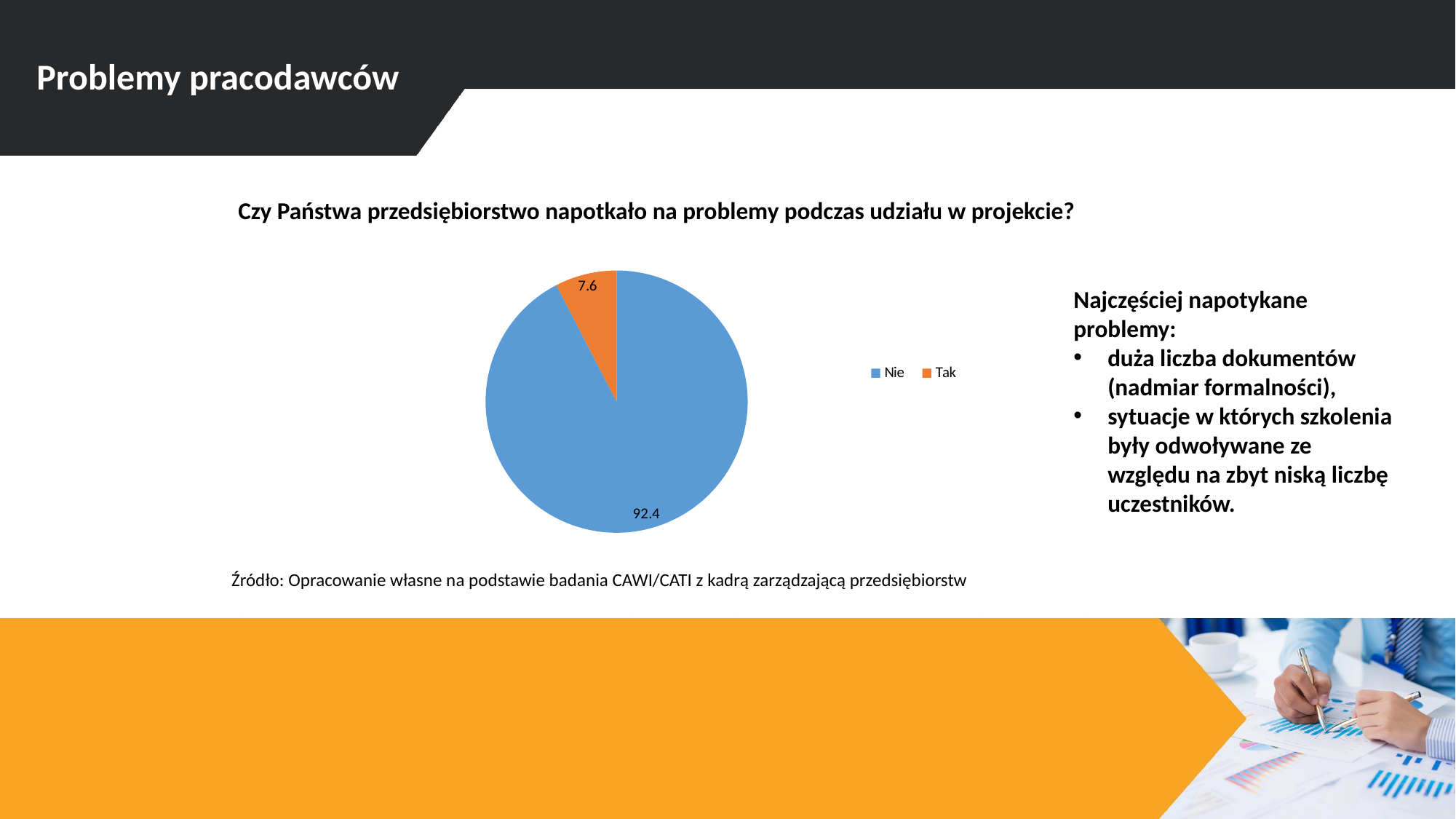
How many entries does the legend list? 2 What is the difference between the values for "Nie" and "Tak"? 84.8 What kind of chart is shown on the slide? pie chart What is the title of the chart? Czy Państwa przedsiębiorstwo napotkało na problemy podczas udziału w projekcie? How many categories does the pie chart have? 2 What is the total of the two slice values in the pie chart? 100 What is the value for "Nie" in the pie chart? 92.4 Which category has the largest slice in the pie chart? Nie Which category has the smallest slice in the pie chart? Tak Which is larger, the value for "Nie" or the value for "Tak"? Nie What colour is the "Tak" slice in the pie chart? orange What is the value for "Tak" in the pie chart? 7.6